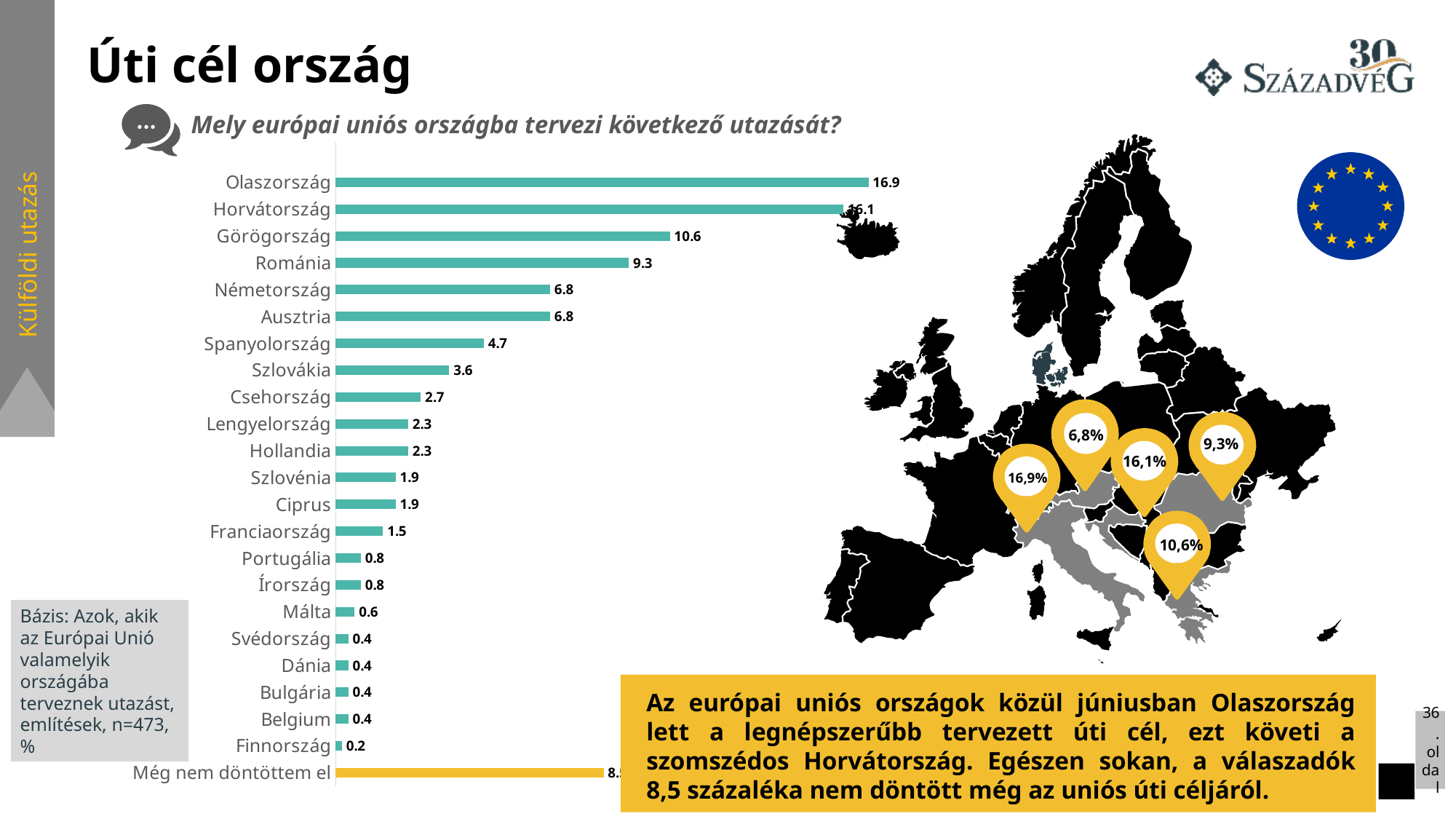
What kind of chart is shown on the slide? bar chart What is the value for Szlovákia? 3.6 What is the value for Görögország? 10.6 What is the value for Olaszország? 16.9 Which country has the highest value in the chart? Olaszország What question is the chart answering, as written above it? Mely európai uniós országba tervezi következő utazását? How many categories (bars) are shown in the chart? 23 Which category has the lowest value in the chart? Finnország What is the difference between the values for Olaszország and Görögország? 6.3 Which has a larger value, Spanyolország or Szlovákia? Spanyolország What is the value for Finnország? 0.2 What is the value for Románia? 9.3